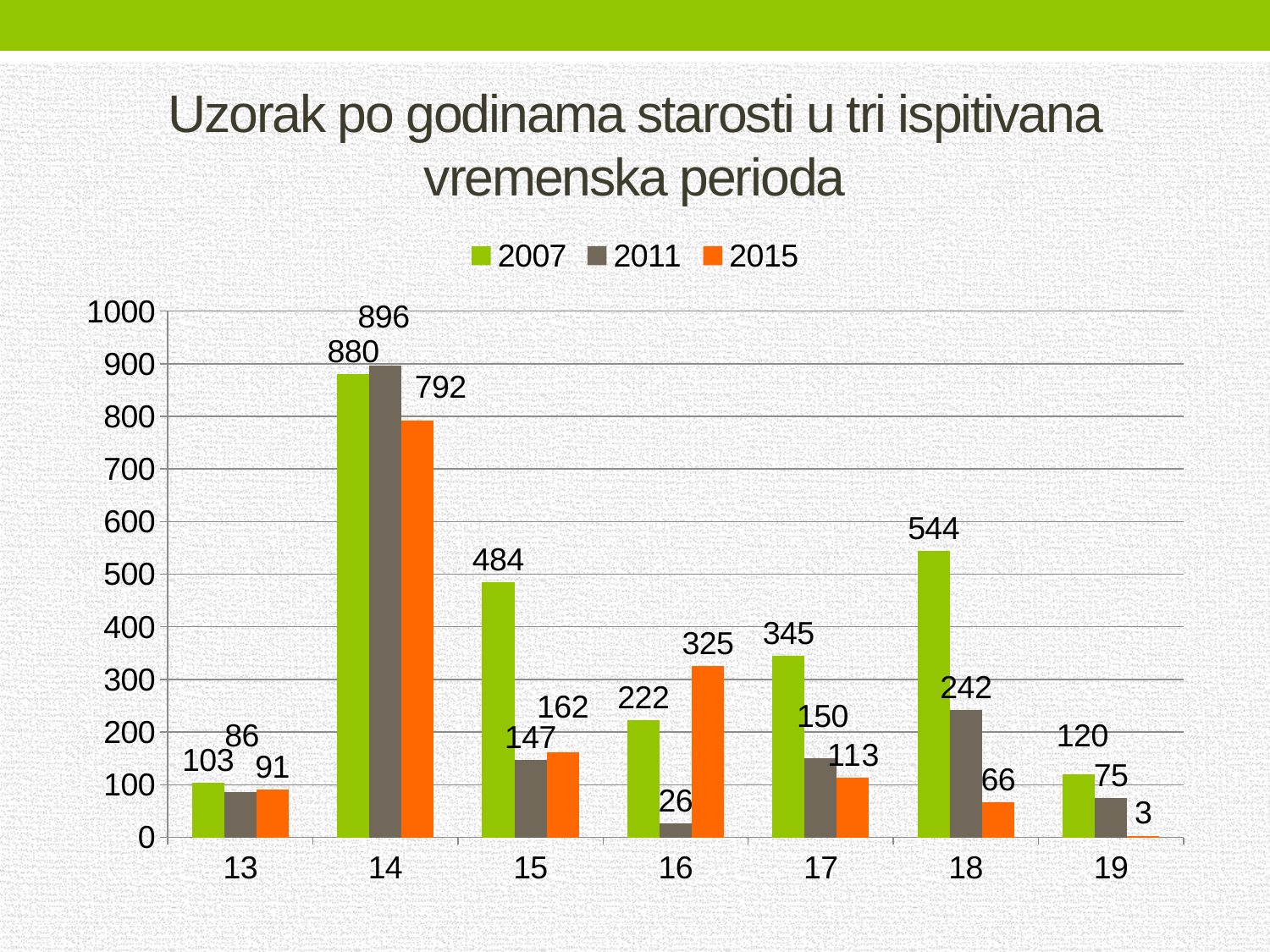
How many age categories are shown on the x axis? 7 What kind of chart is shown on the slide? bar chart Which is larger for age 16: the 2007 value or the 2015 value? 2015 Is the value for age 18 in the 2007 series greater or less than 500? greater What is the value for age 16 in the 2015 series? 325 How many series does the legend list? 3 Which series is shown in orange in the legend? 2015 Which age category has the highest value in the 2007 series? 14 Which age category has the lowest value in the 2015 series? 19 What is the value for age 19 in the 2007 series? 120 What is the value for age 14 in the 2011 series? 896 What is the difference between the 2007 and 2015 values for age 14? 88